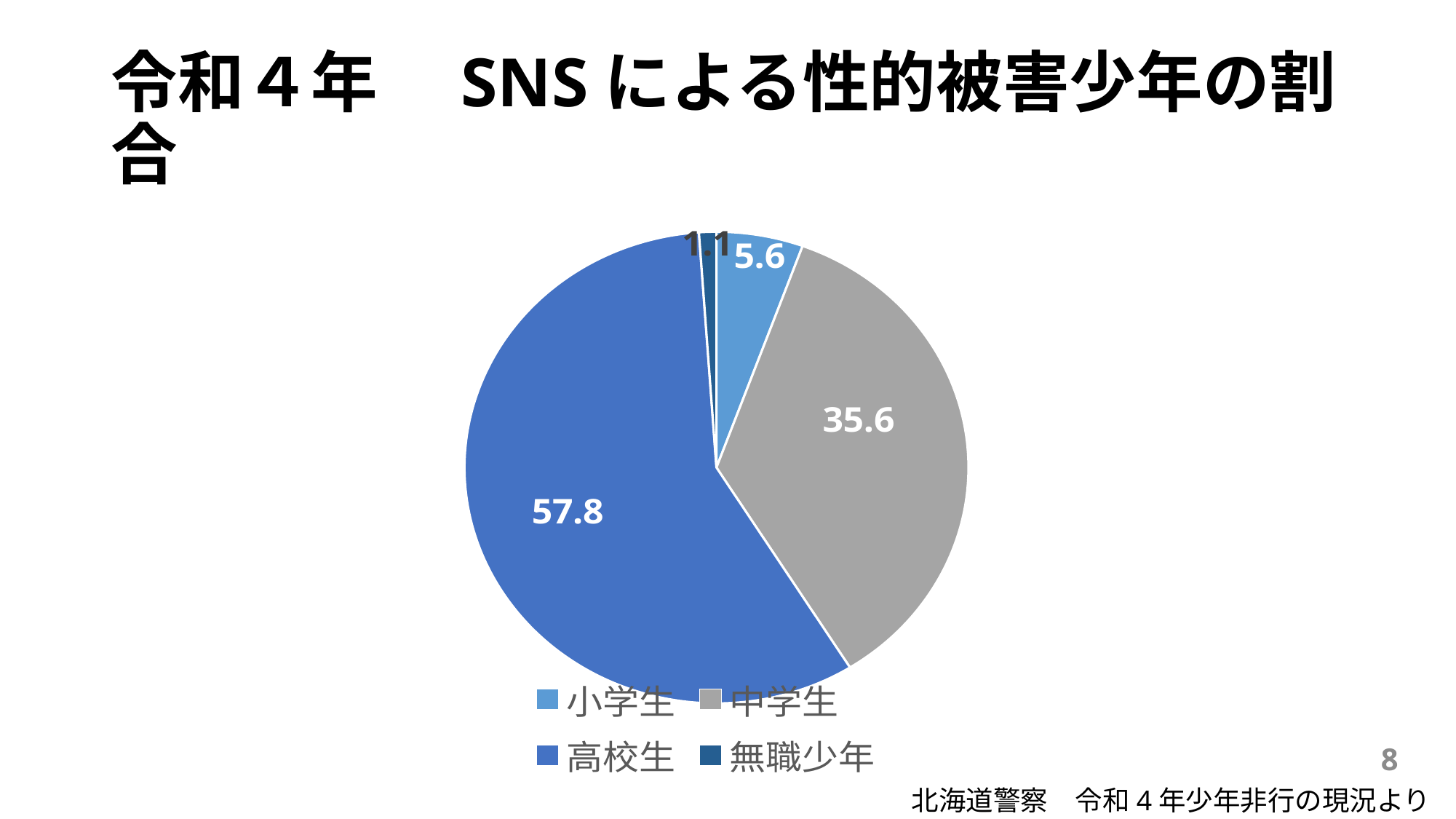
Which is larger, the value for 小学生 or the value for 無職少年? 小学生 Which category has the smallest slice of the pie chart? 無職少年 Which category is shown in grey in the pie chart? 中学生 What is the difference between the values for 高校生 and 中学生? 22.2 What is the value for 小学生 in the pie chart? 5.6 What is the value for 無職少年 in the pie chart? 1.1 What kind of chart is shown on the slide? pie chart Which category has the largest slice of the pie chart? 高校生 What is the value for 中学生 in the pie chart? 35.6 What is the title of the chart on the slide? 令和4年 SNSによる性的被害少年の割合 What is the value for 高校生 in the pie chart? 57.8 How many categories does the pie chart show? 4